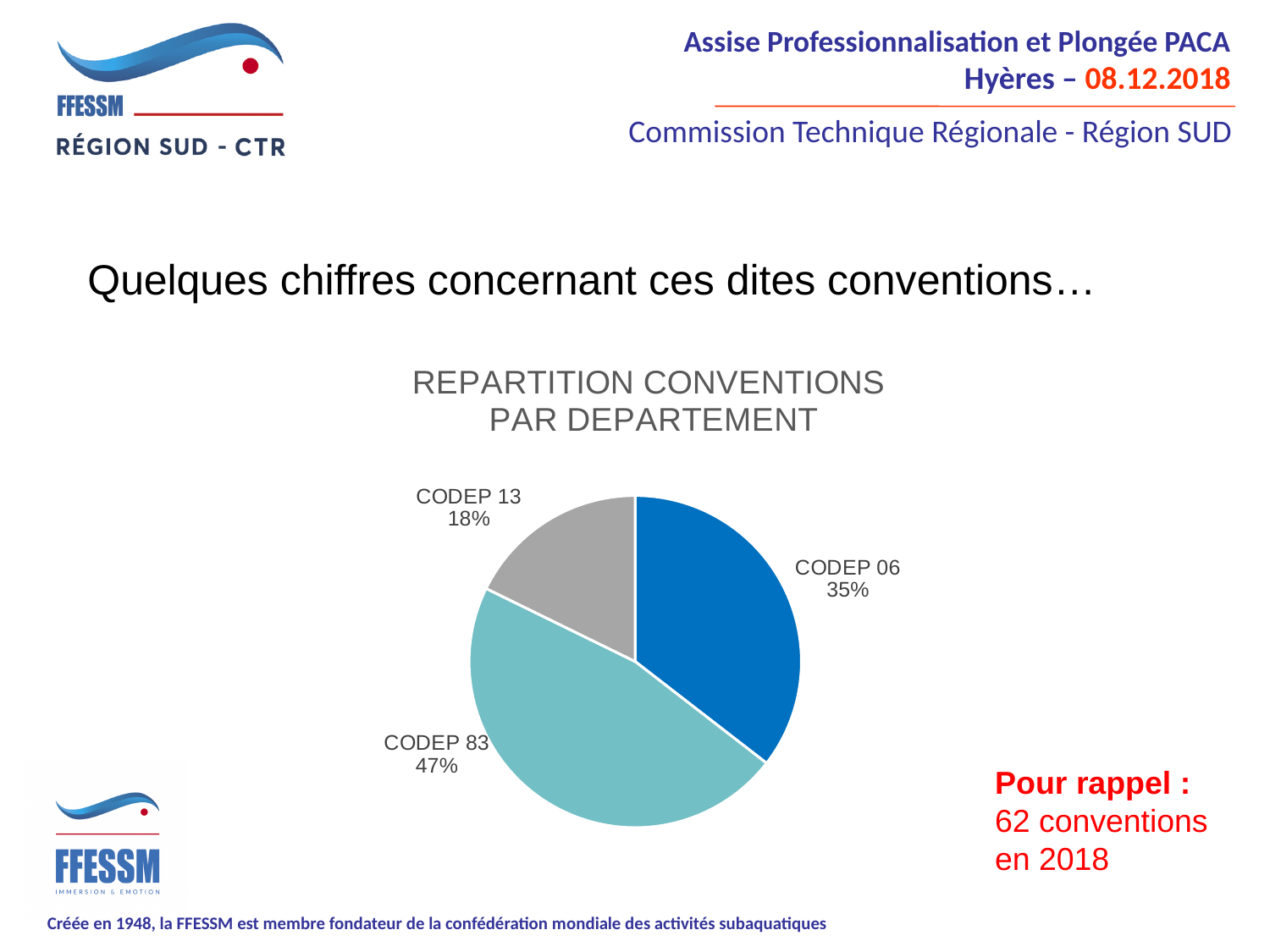
What kind of chart is shown on the slide? pie chart What share of the pie does CODEP 13 represent? 18% What is the difference in percentage points between CODEP 83 and CODEP 06? 12 What colour is the CODEP 13 slice? grey Which department has the smallest share of conventions? CODEP 13 What share of the pie does CODEP 83 represent? 47% What share of the pie does CODEP 06 represent? 35% What is the difference in percentage points between CODEP 06 and CODEP 13? 17 How many slices does the pie chart have? 3 Which has a larger share, CODEP 06 or CODEP 13? CODEP 06 What is the title of the chart? REPARTITION CONVENTIONS PAR DEPARTEMENT Which department has the largest share of conventions? CODEP 83